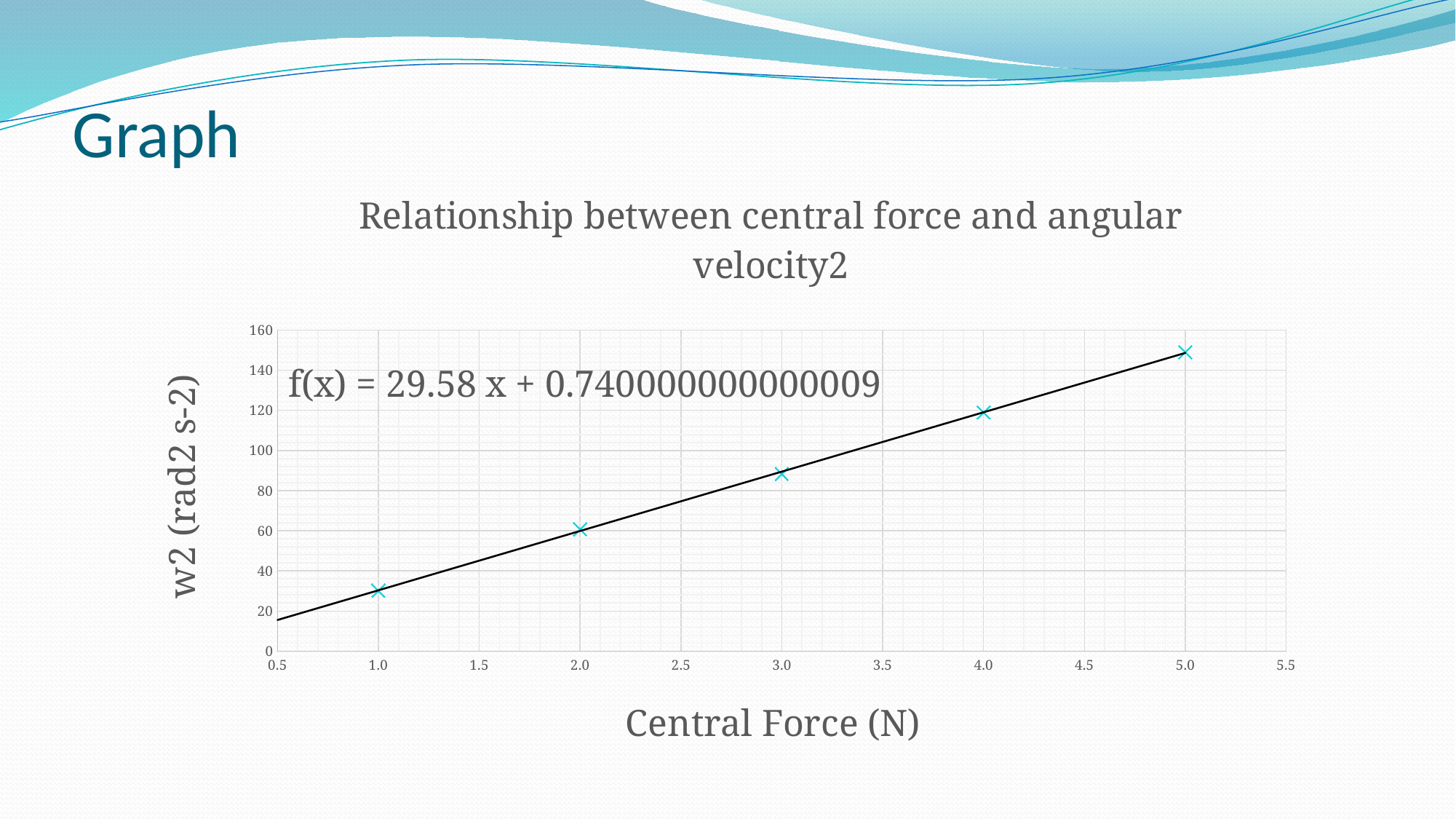
Which central force has the lowest plotted value? 1.0 What is the title of the chart? Relationship between central force and angular velocity2 Is the value for a central force of 5.0 N greater or less than 140? greater Is the value for a central force of 4.0 N greater or less than 100? greater How many data points are plotted on the chart? 5 Is the value for a central force of 2.0 N greater or less than 40? greater What kind of chart is shown on the slide? scatter chart Do the plotted values rise or fall as central force increases along the x axis? rise Which central force has the highest plotted value? 5.0 What is the label of the x axis? Central Force (N)